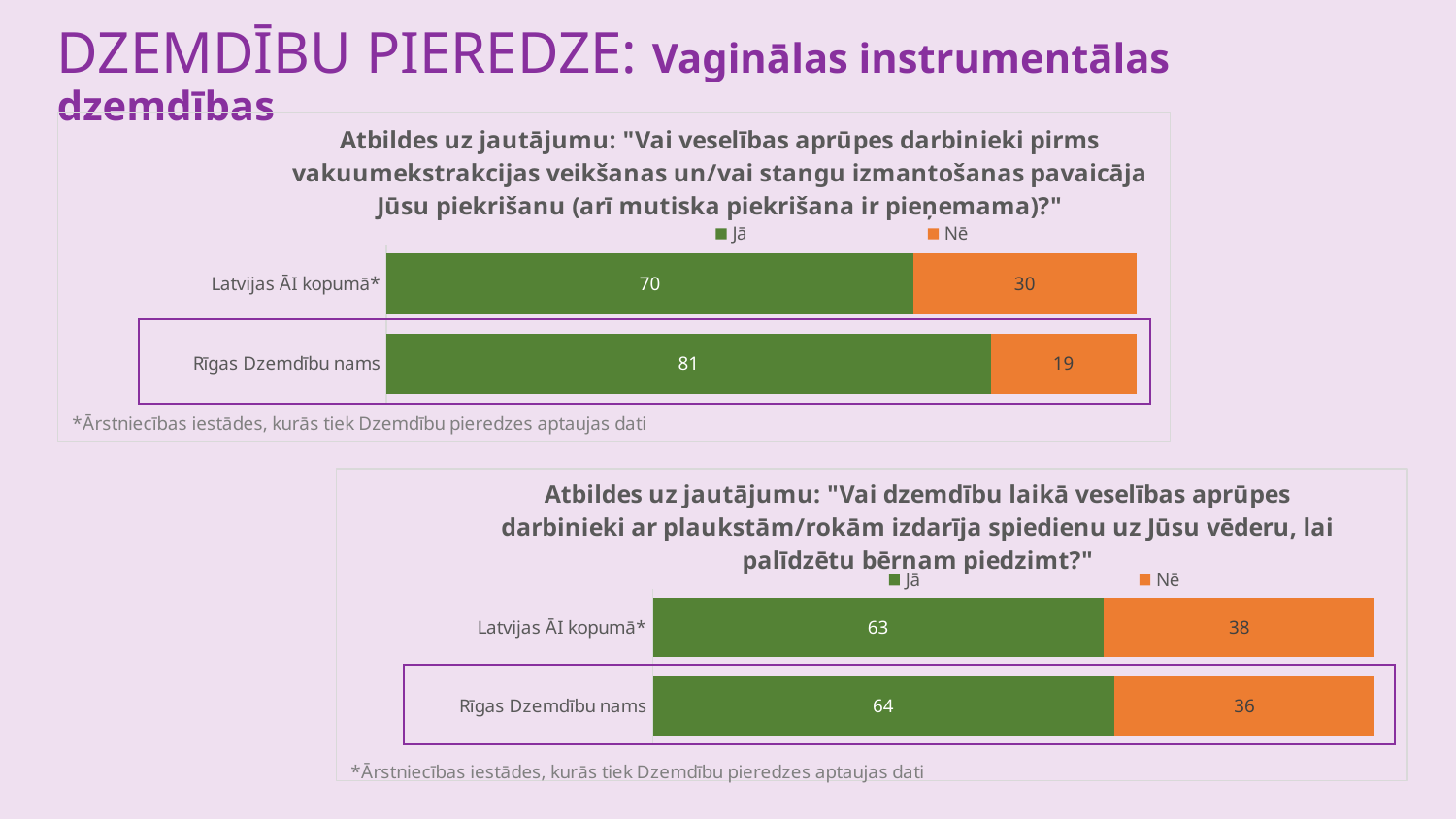
In the bottom chart, what is the difference between the "Nē" values for Latvijas ĀI kopumā* and Rīgas Dzemdību nams? 2 In the top chart, what is the "Nē" value for Latvijas ĀI kopumā*? 30 In the bottom chart, is the "Jā" value for Rīgas Dzemdību nams larger or smaller than its "Nē" value? larger In the top chart, what is the "Jā" value for Rīgas Dzemdību nams? 81 How many categories are shown in the bottom chart? 2 What kind of chart is the bottom chart? Stacked bar chart In the top chart, which category has the higher "Jā" value? Rīgas Dzemdību nams In the top chart, what is the difference between the "Jā" values for Rīgas Dzemdību nams and Latvijas ĀI kopumā*? 11 In the top chart, which category has the lower "Nē" value? Rīgas Dzemdību nams How many series does the legend of the top chart list? 2 In the bottom chart, what is the "Nē" value for Rīgas Dzemdību nams? 36 In the bottom chart, what is the "Jā" value for Latvijas ĀI kopumā*? 63